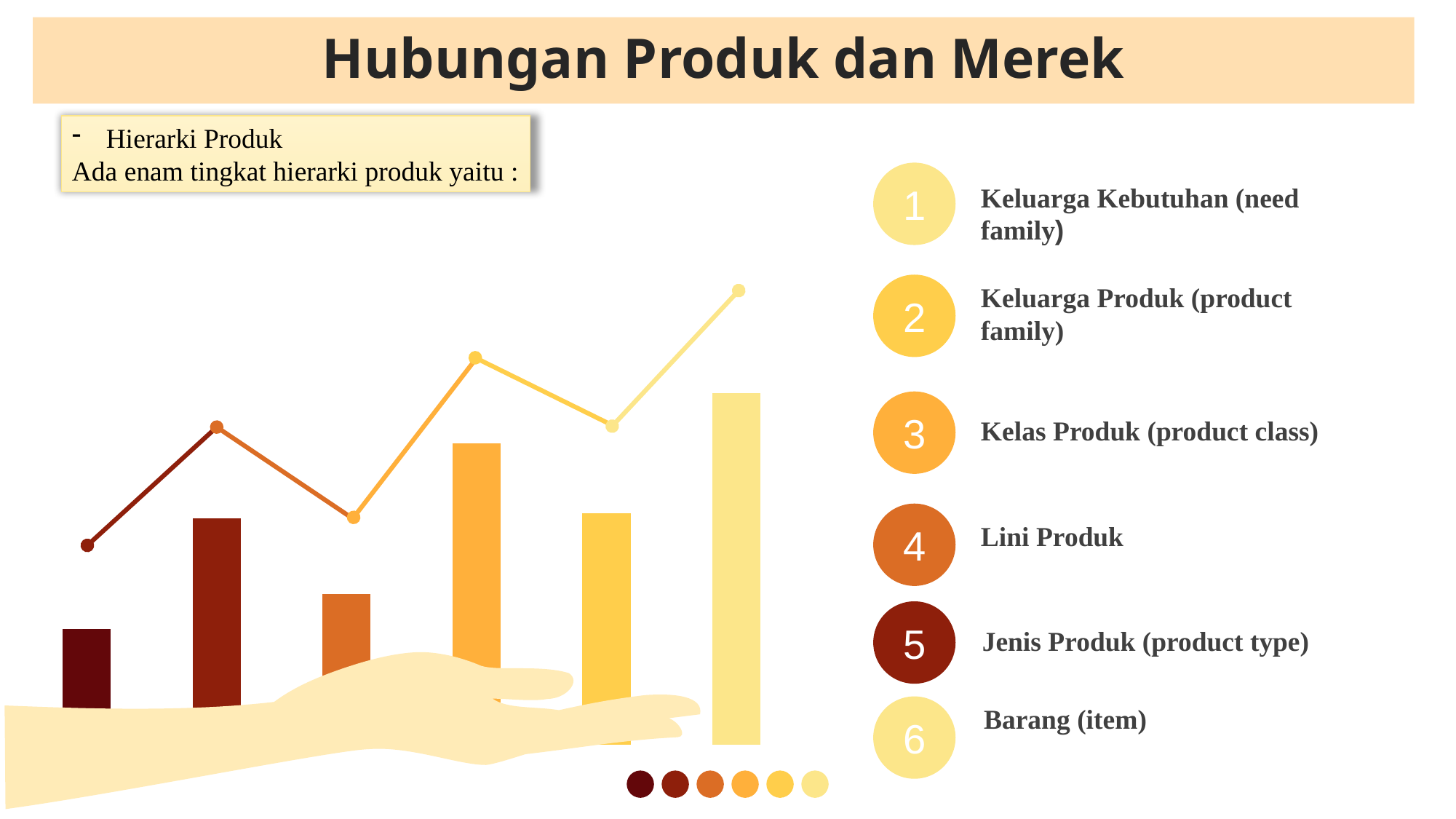
How many points are plotted on the line in the chart? 6 Which bar in the chart is the tallest? The rightmost bar How many bars does the chart on the slide have? 6 What kind of chart is shown on the left side of the slide? A bar chart with a line overlaid Which bar in the chart is the shortest? The leftmost bar Does the chart show any axis labels or data values? No Is the rightmost bar taller or shorter than the leftmost bar? Taller